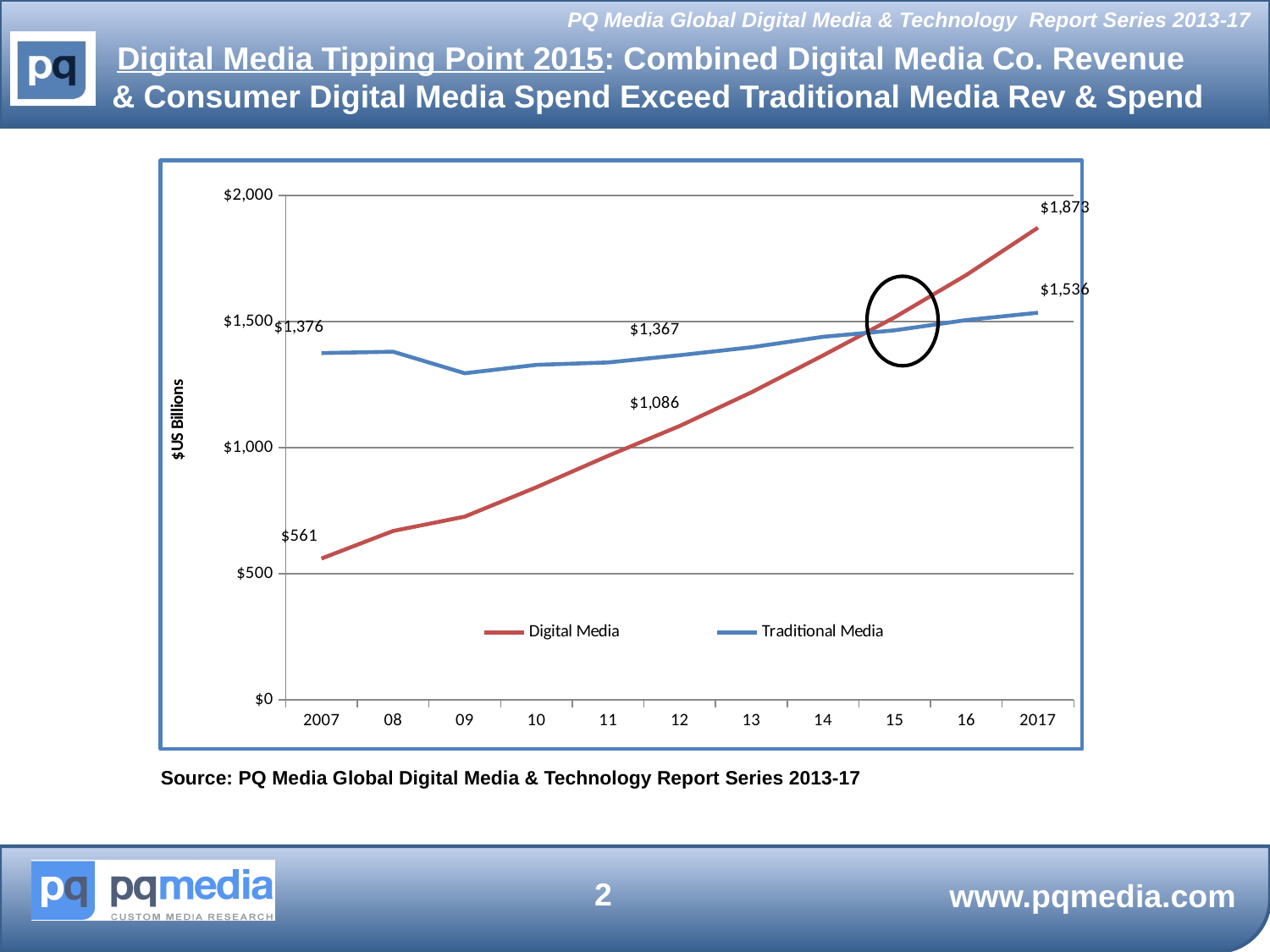
Is the Digital Media value in 2015 greater or less than $1,000? greater Does the Digital Media line rise or fall from 2007 to 2017? rise Which series has the larger value in 2012, Digital Media or Traditional Media? Traditional Media What type of chart is shown on the slide? line chart What is the difference between the Digital Media and Traditional Media values in 2017? $337 How many years are shown on the x axis? 11 What is the Digital Media value in 2017? $1,873 What is the Traditional Media value in 2012? $1,367 How many series does the legend list? 2 What is the Traditional Media value in 2017? $1,536 What unit is shown on the y axis label? $US Billions What is the Digital Media value in 2007? $561